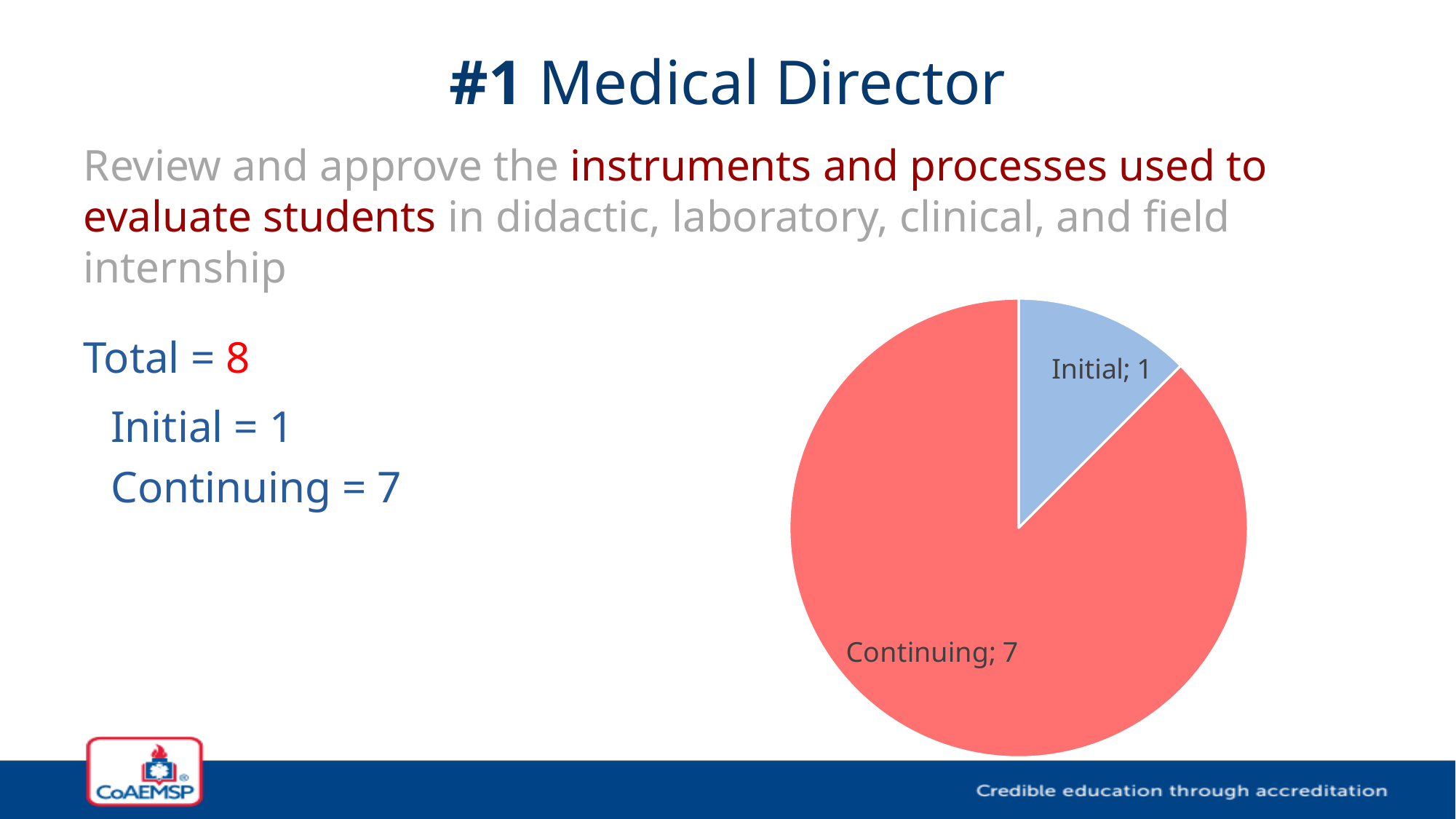
What colour is the Continuing slice of the pie chart? red Which is larger in the pie chart, Initial or Continuing? Continuing What is the value for the Continuing slice of the pie chart? 7 Which slice of the pie chart is the largest? Continuing What is the total of all slices in the pie chart? 8 What kind of chart is shown on the slide? pie chart What share of the pie chart does the Continuing slice represent? 7/8 Which slice of the pie chart is the smallest? Initial What is the value for the Initial slice of the pie chart? 1 What colour is the Initial slice of the pie chart? light blue How many slices does the pie chart have? 2 What is the difference between the Continuing and Initial values in the pie chart? 6